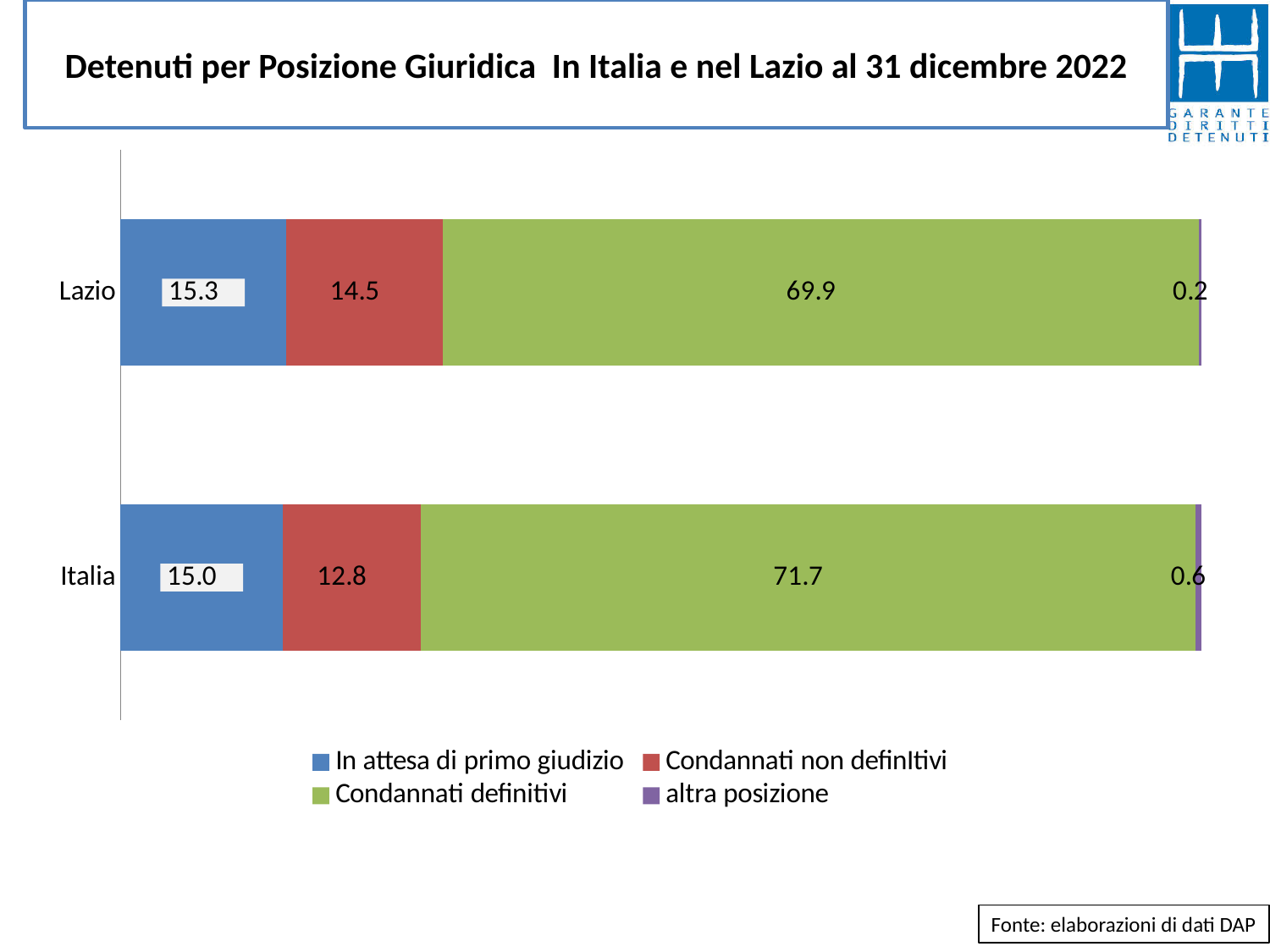
What kind of chart is shown on the slide? Stacked bar chart What is the value for 'altra posizione' for Italia? 0.6 How many series does the legend list? 4 How many categories are shown on the chart? 2 What is the value for 'Condannati definitivi' for Lazio? 69.9 What is the difference between the 'Condannati definitivi' values for Italia and Lazio? 1.8 Which series has the largest value for Italia? Condannati definitivi Which series has the smallest value for Lazio? altra posizione Which is larger, the 'Condannati non definitivi' value for Lazio or for Italia? Lazio What is the value for 'In attesa di primo giudizio' for Italia? 15.0 What is the value for 'Condannati non definitivi' for Lazio? 14.5 What is the title of the chart? Detenuti per Posizione Giuridica In Italia e nel Lazio al 31 dicembre 2022